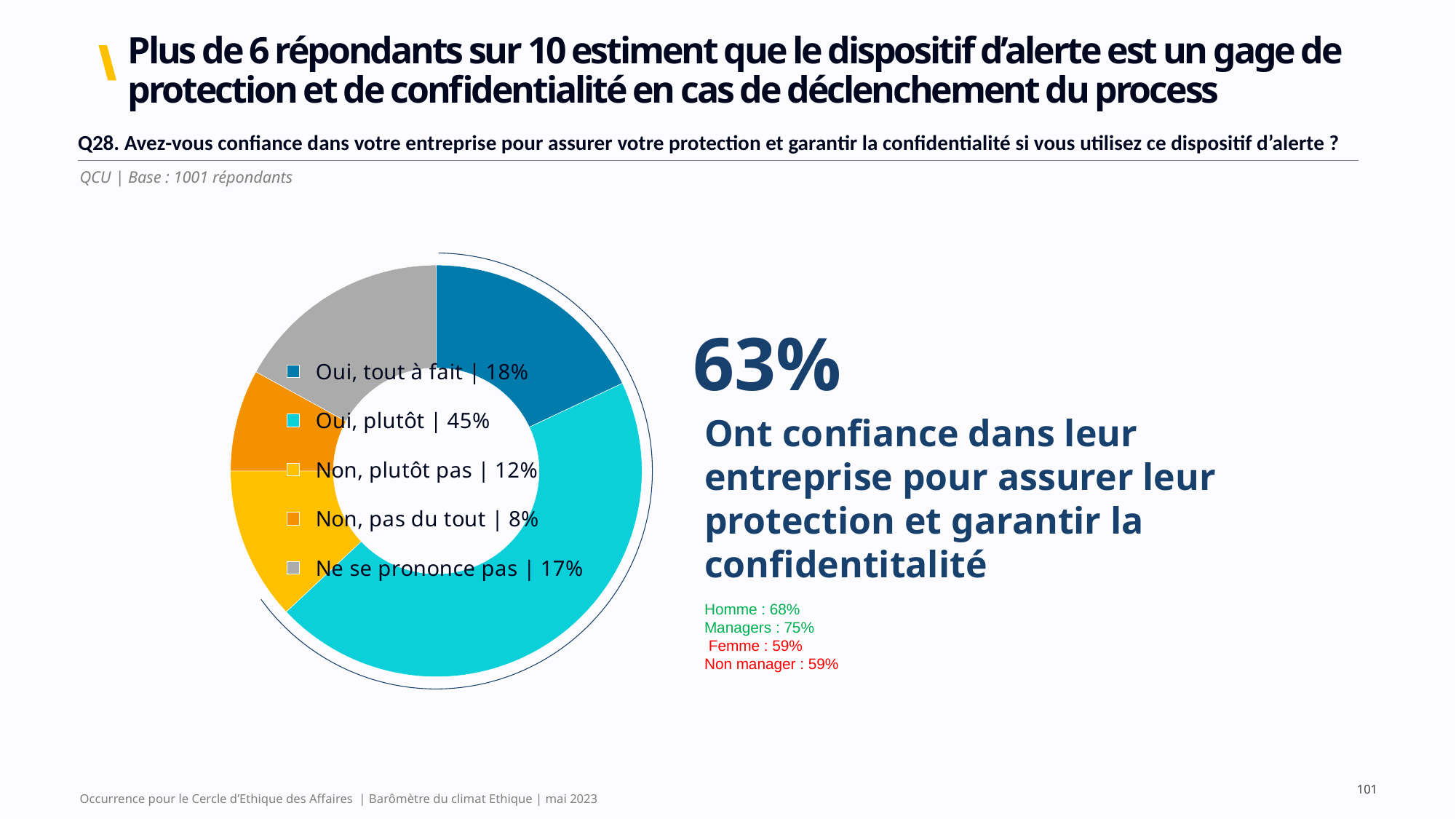
What is the difference in percentage points between "Oui, plutôt" and "Oui, tout à fait"? 27 Which response category has the largest share of the pie? Oui, plutôt How many response categories does the pie chart show? 5 What percentage of respondents answered "Oui, plutôt"? 45% What is the combined share of "Oui, tout à fait" and "Oui, plutôt"? 63% What percentage of respondents answered "Non, pas du tout"? 8% What percentage of respondents answered "Ne se prononce pas"? 17% Which response category has the smallest share of the pie? Non, pas du tout Which is larger: the share for "Non, plutôt pas" or the share for "Ne se prononce pas"? Ne se prononce pas What percentage of respondents answered "Oui, tout à fait"? 18% What colour is the slice for "Ne se prononce pas"? Grey What kind of chart is shown on the slide? Pie chart (donut)